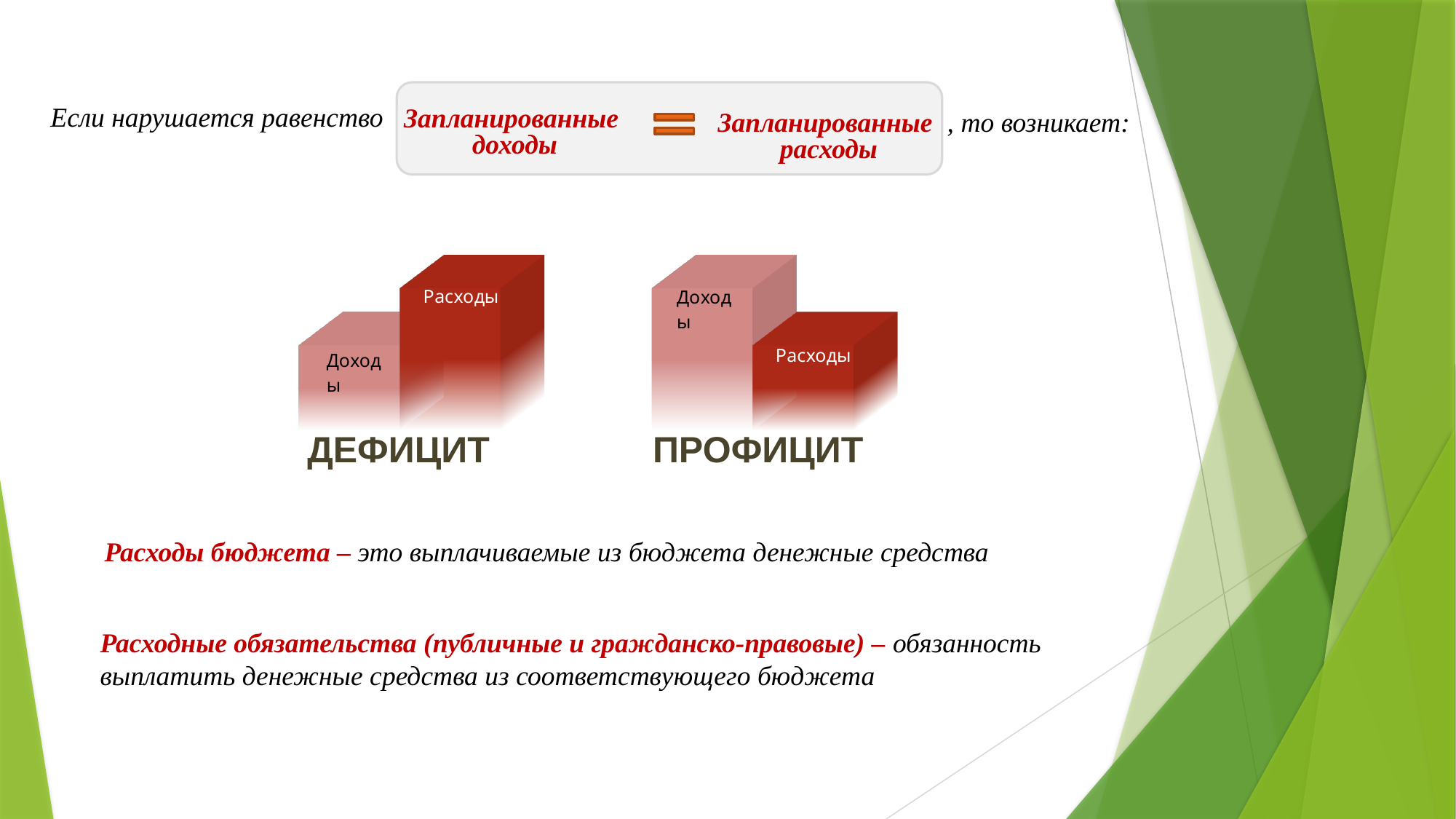
In the ПРОФИЦИТ chart, which bar is the highest? Доходы How many bar charts are shown on the slide? 1 In the ДЕФИЦИТ chart, which bar is taller, Доходы or Расходы? Расходы In the ПРОФИЦИТ chart, what colour is the Расходы bar? Dark red How many bars are shown in the ДЕФИЦИТ chart? 2 In the ДЕФИЦИТ chart, which bar is the lowest? Доходы What is the label under the left chart, where Расходы exceeds Доходы? ДЕФИЦИТ In the ПРОФИЦИТ chart, which bar is taller, Доходы or Расходы? Доходы In the ПРОФИЦИТ chart, which bar is the lowest? Расходы What kind of chart is used to illustrate ДЕФИЦИТ and ПРОФИЦИТ? Bar chart In the ДЕФИЦИТ chart, which bar is the highest? Расходы How many bars are shown in the ПРОФИЦИТ chart? 2